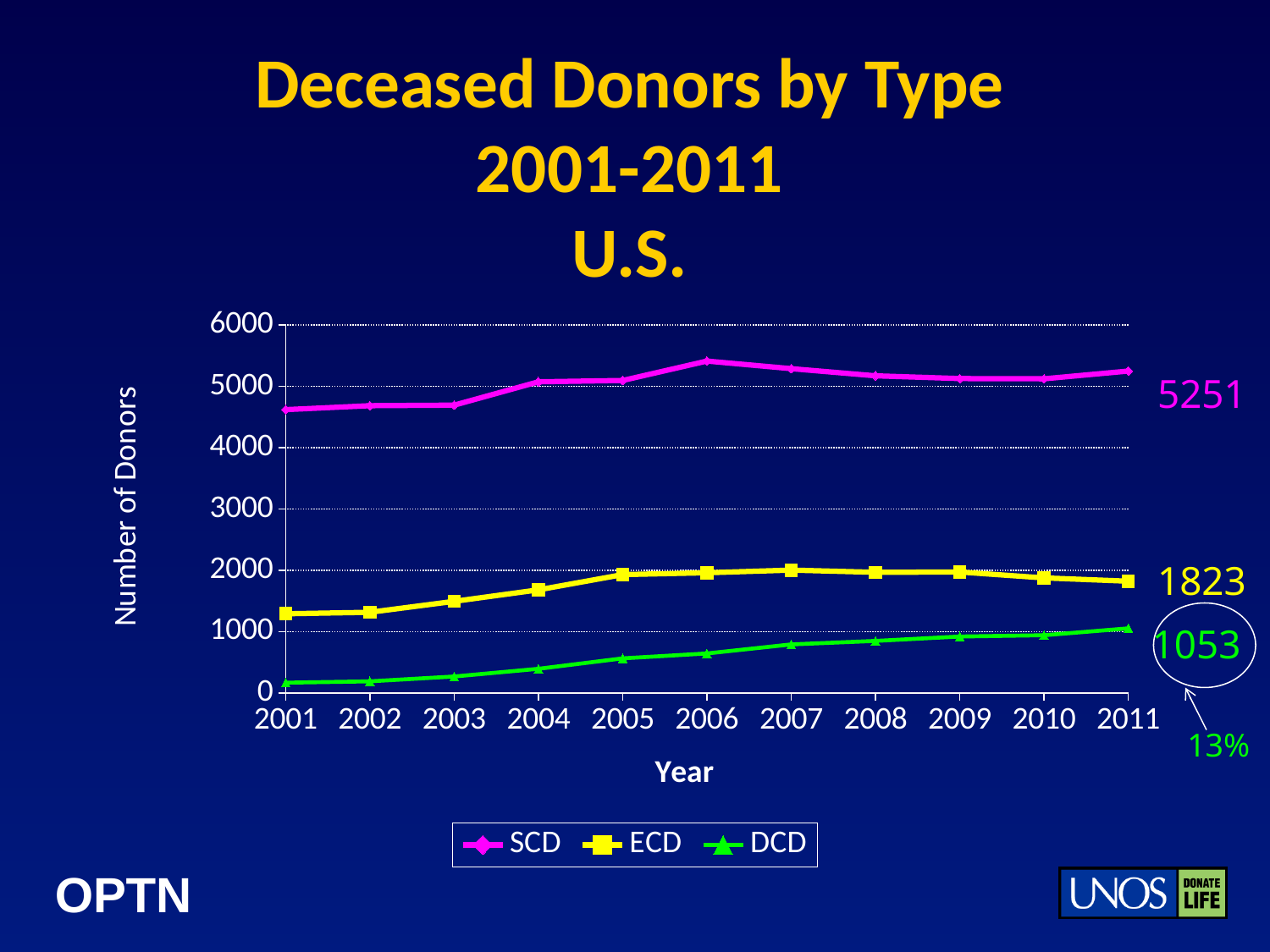
How many years are shown on the x axis? 11 What is the difference between the SCD and ECD values in 2011? 3428 What is the number of ECD donors in 2011? 1823 What is the number of DCD donors in 2011? 1053 Which series has the lowest value in 2011? DCD Is the value for DCD in 2001 greater or less than 1000? less How many series does the legend list? 3 What kind of chart is shown on the slide? line chart What is the number of SCD donors in 2011? 5251 Is the value for SCD in 2001 greater or less than 4000? greater What is the difference between the ECD and DCD values in 2011? 770 Which series has the highest value in 2011? SCD